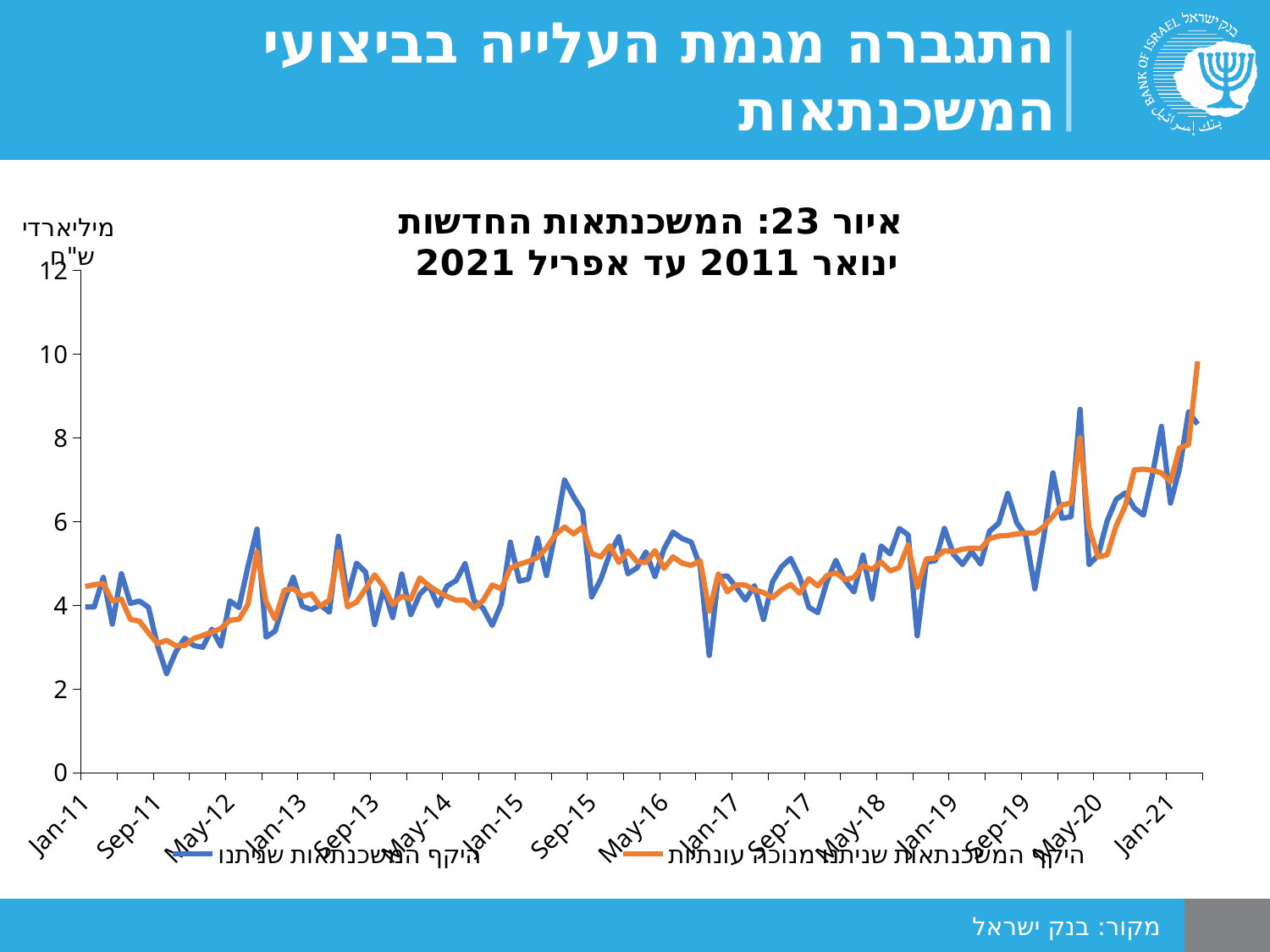
Is the value of the orange series (היקף המשכנתאות שניתנו מנוכה עונתיות) at Jan-17 greater or less than 6? less Is the peak of the blue series (היקף המשכנתאות שניתנו) around Sep-15 greater or less than 6? greater Is the value of the orange seasonally adjusted series (היקף המשכנתאות שניתנו מנוכה עונתיות) at the last point of the chart greater or less than 8? greater Overall, do the values rise or fall from Jan-11 to the end of the series in 2021? rise What is the title of the chart? איור 23: המשכנתאות החדשות ינואר 2011 עד אפריל 2021 What kind of chart is shown on the slide? line chart How many series does the legend list? 2 At the last point of the chart, which series is higher: the blue series or the orange series? the orange series What unit is shown on the vertical axis of the chart? מיליארדי ש"ח What is the highest tick value shown on the vertical axis? 12